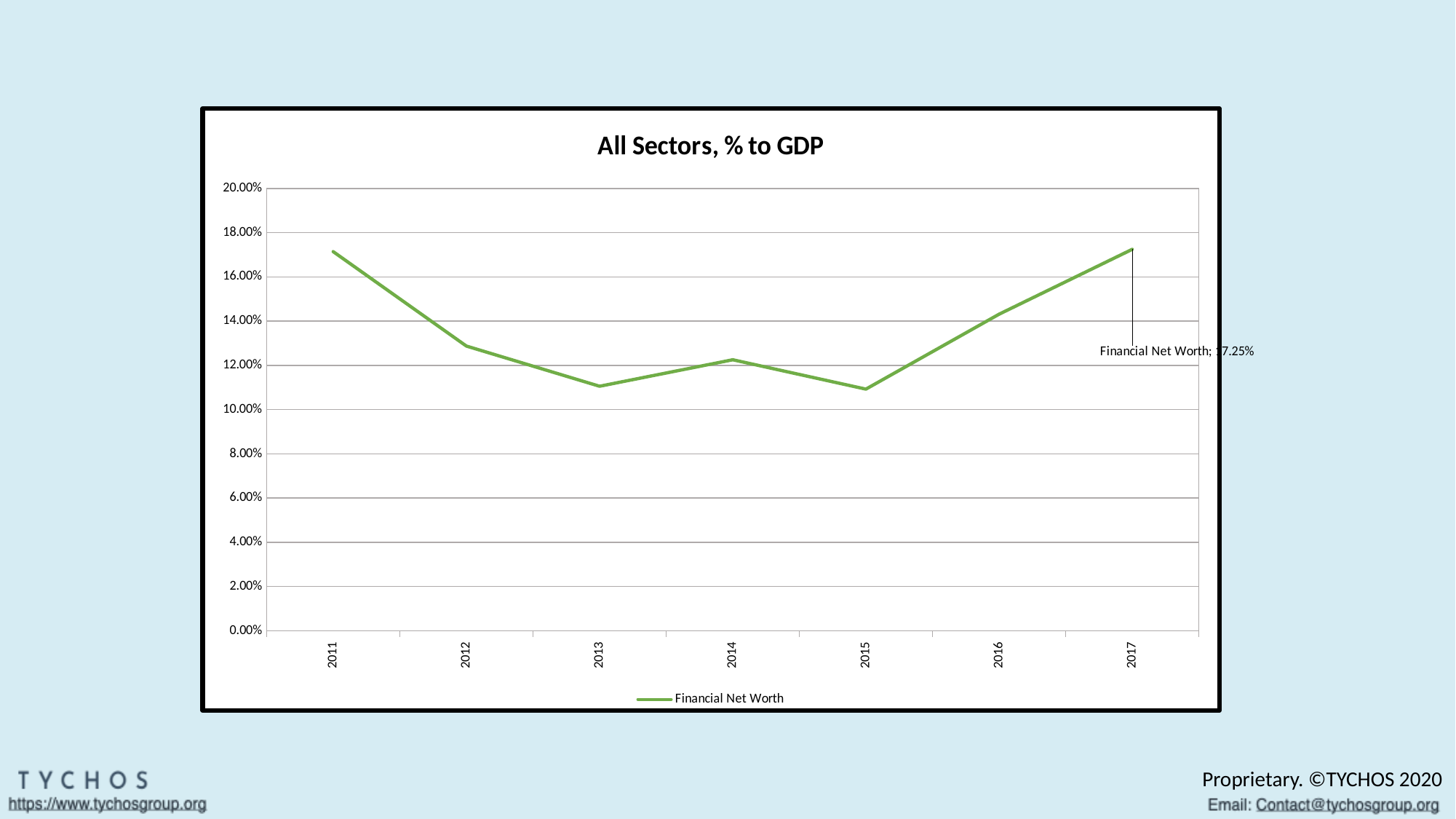
What is the name of the series shown in the legend? Financial Net Worth Is the value for 2013 greater or less than 12.00%? less Does the value rise or fall from 2015 to 2017? rise Is the value for 2011 greater or less than 16.00%? greater Which year has the larger value, 2016 or 2013? 2016 How many series does the legend list? 1 Is the value for 2015 greater or less than 10.00%? greater What is the value of Financial Net Worth in 2017? 17.25% What is the title of the chart? All Sectors, % to GDP How many years are plotted on the x axis? 7 What type of chart is shown on the slide? line chart